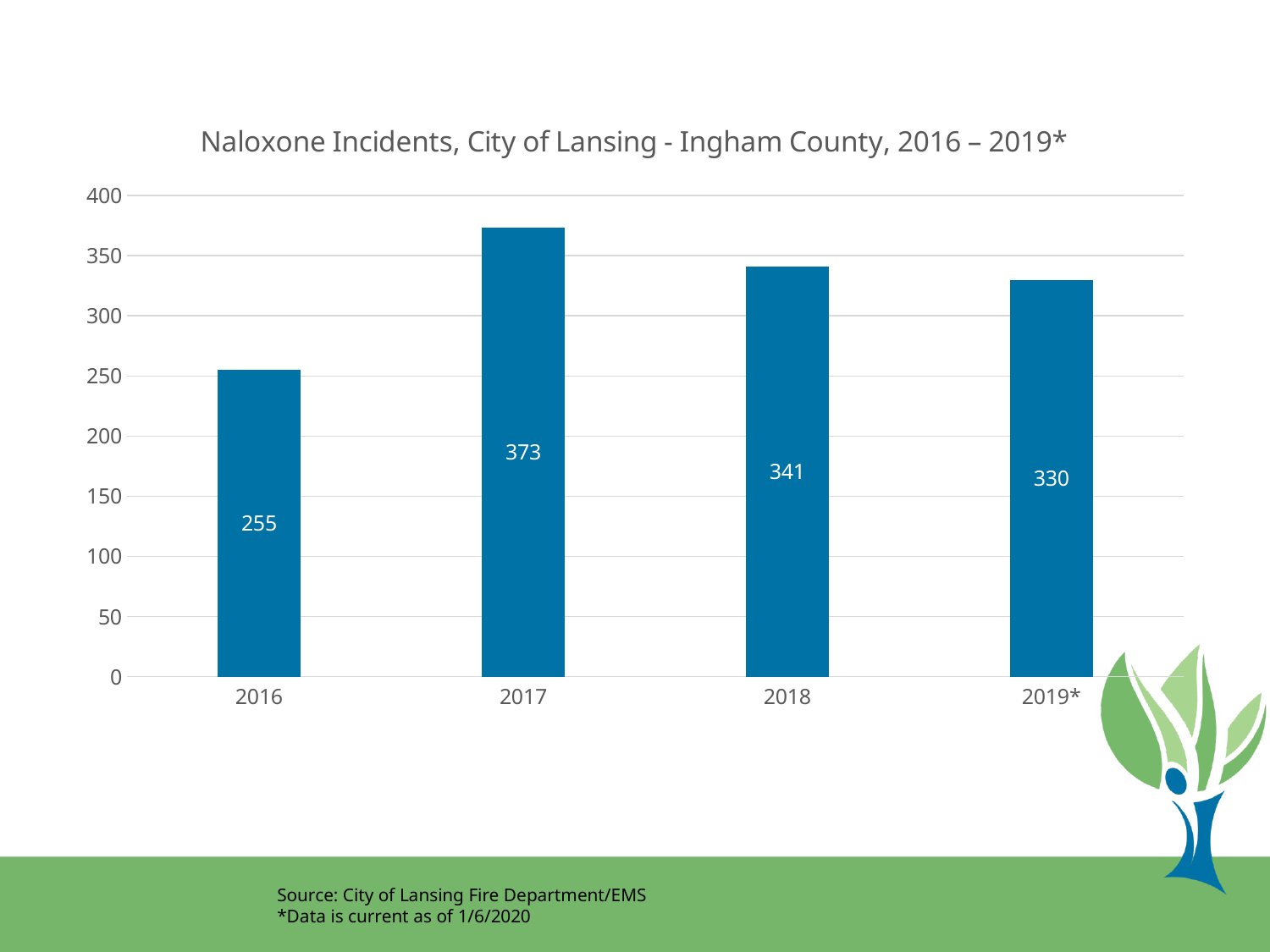
What is the number of naloxone incidents in 2018? 341 What is the difference in naloxone incidents between 2017 and 2016? 118 What is the number of naloxone incidents in 2016? 255 Is the value for 2016 greater or less than 300? less What is the difference in naloxone incidents between 2018 and 2019*? 11 Which year has the highest number of naloxone incidents? 2017 What is the number of naloxone incidents in 2019*? 330 Which year has the lowest number of naloxone incidents? 2016 How many years are shown on the chart? 4 What is the number of naloxone incidents in 2017? 373 What type of chart is shown on the slide? Bar chart Which year had more naloxone incidents, 2018 or 2019*? 2018